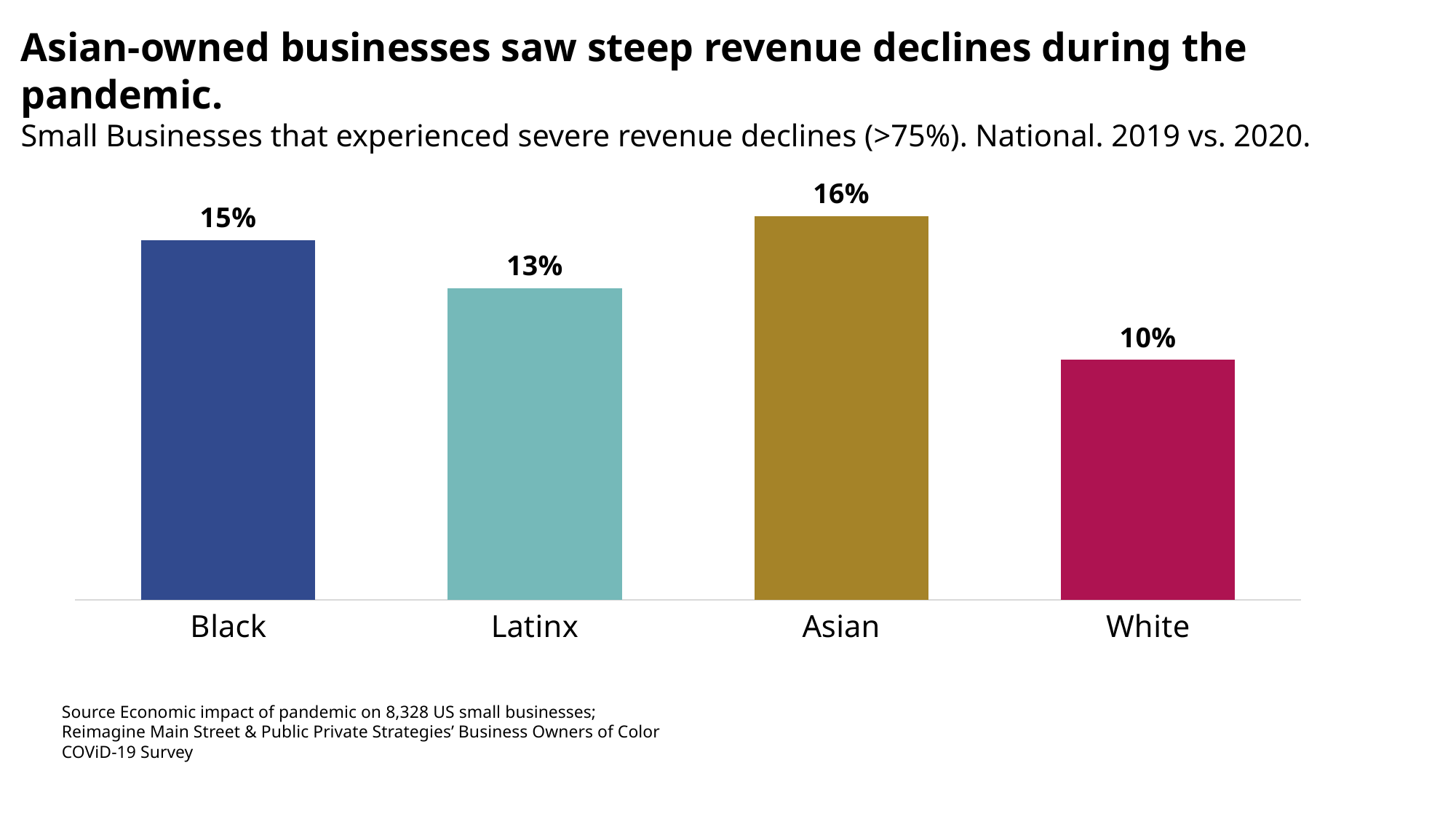
Which group has the highest share of businesses with severe revenue declines? Asian Which group has the lowest share of businesses with severe revenue declines? White What is the difference in percentage points between the Asian and White values? 6 percentage points What percentage of Black-owned small businesses experienced severe revenue declines? 15% What kind of chart is shown on the slide? Bar chart What is the value shown for Latinx-owned businesses? 13% What is the value shown for Asian-owned businesses? 16% Which is larger, the value for Black or the value for Latinx? Black What is the difference in percentage points between the Black and Latinx values? 2 percentage points What is the value shown for White-owned businesses? 10% What colour is the bar for Asian-owned businesses? Gold How many groups are shown on the chart? 4